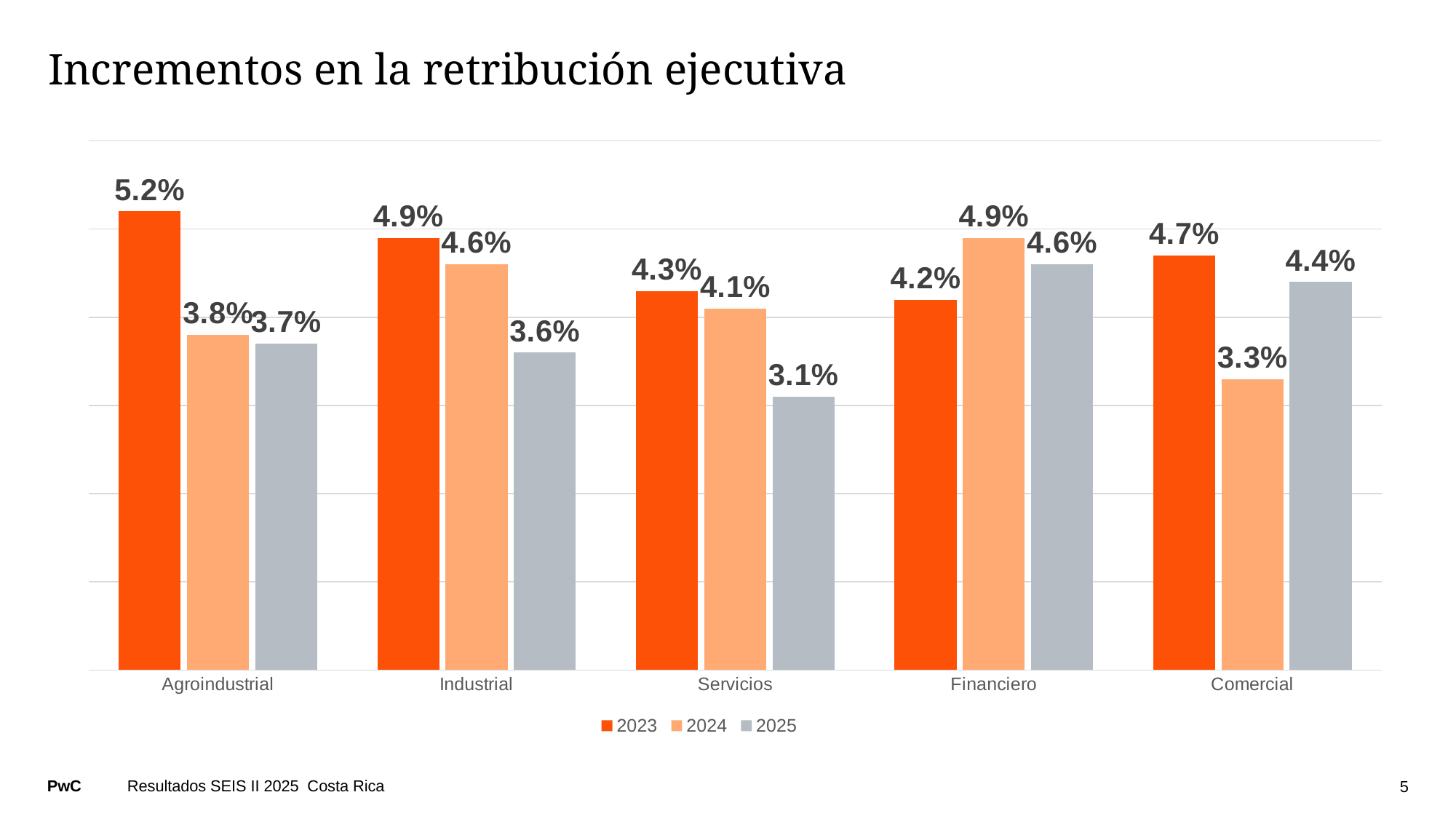
What is the value for Comercial in 2024? 3.3% What is the value for Servicios in 2025? 3.1% What kind of chart is shown on the slide? Bar chart What is the value for Agroindustrial in 2023? 5.2% Which category has the highest value in 2023? Agroindustrial Which category has the lowest value in 2025? Servicios How many series does the legend list? 3 What is the difference between the 2023 and 2025 values for Agroindustrial? 1.5% Which is larger for Comercial, the 2024 value or the 2025 value? 2025 What is the value for Financiero in 2024? 4.9% How many categories are shown on the x axis? 5 What is the title of the slide? Incrementos en la retribución ejecutiva